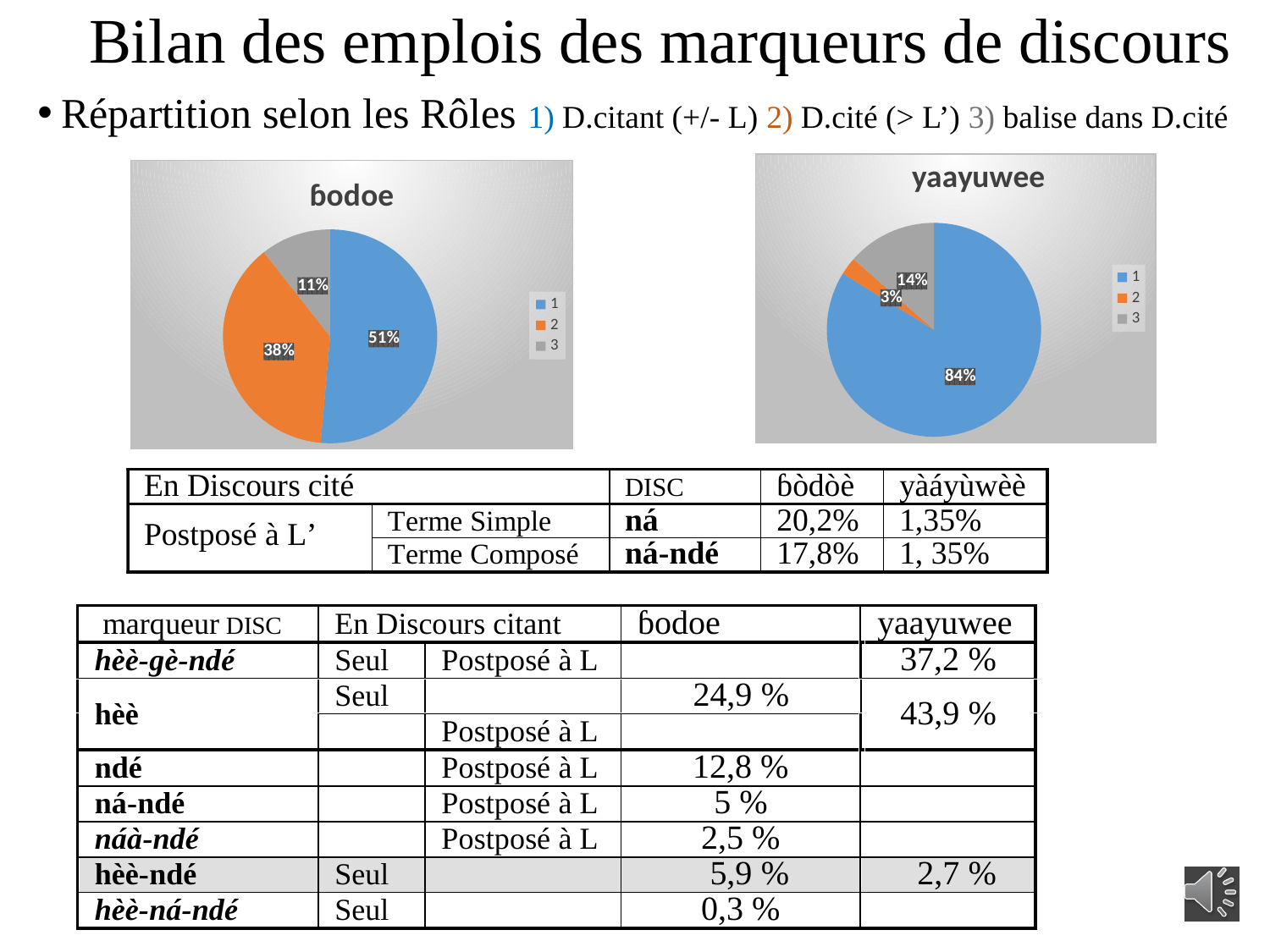
In the right pie chart titled yaayuwee, what percentage is shown for category 3? 14% In the right pie chart titled yaayuwee, which category has the smallest slice? 2 In the left pie chart titled ɓodoe, what percentage is shown for category 3? 11% In the left pie chart titled ɓodoe, what percentage is shown for category 1? 51% In the left pie chart titled ɓodoe, which category has the largest slice? 1 How many slices does the right pie chart titled yaayuwee have? 3 In the left pie chart titled ɓodoe, what percentage is shown for category 2? 38% In the right pie chart titled yaayuwee, which is larger: the slice for category 3 or the slice for category 2? 3 In the right pie chart titled yaayuwee, what percentage is shown for category 2? 3% In the left pie chart titled ɓodoe, what is the difference in percentage points between category 1 and category 2? 13 What type of chart is the left chart titled ɓodoe? pie chart In the right pie chart titled yaayuwee, what percentage is shown for category 1? 84%